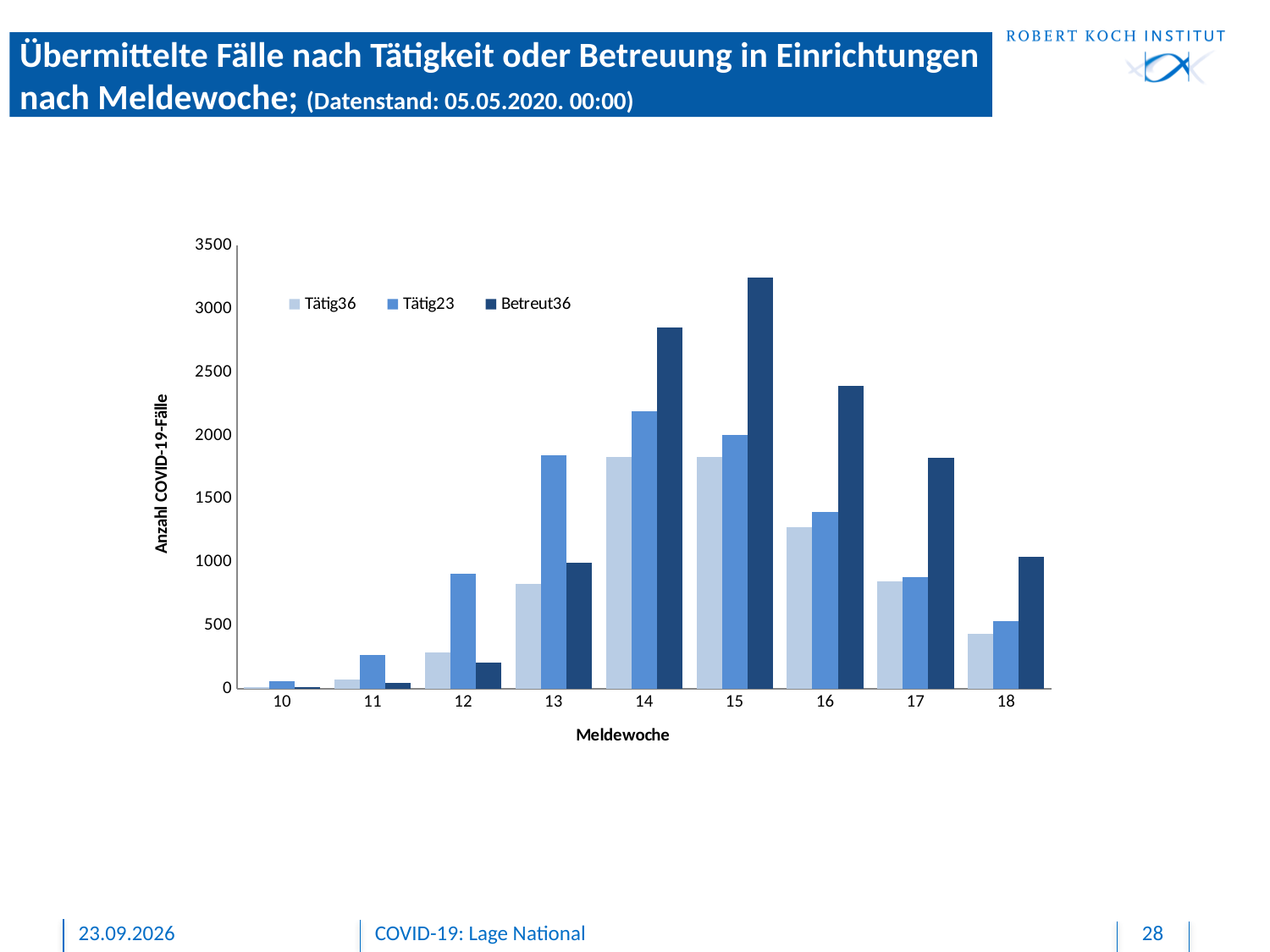
In Meldewoche 13, which is larger: Tätig23 or Betreut36? Tätig23 What kind of chart is shown on the slide? bar chart In which Meldewoche is the Tätig23 value lowest? 10 Do the Betreut36 values rise or fall from Meldewoche 15 to Meldewoche 18? fall In which Meldewoche is the Tätig23 value highest? 14 How many Meldewochen (reporting weeks) are shown on the x axis? 9 What is the title of the y axis? Anzahl COVID-19-Fälle Is the Tätig23 value for Meldewoche 12 greater or less than 1000? less Is the Betreut36 value for Meldewoche 15 greater or less than 3000? greater In Meldewoche 16, which is larger: Tätig36 or Betreut36? Betreut36 In which Meldewoche is the Betreut36 value highest? 15 How many series does the legend list? 3